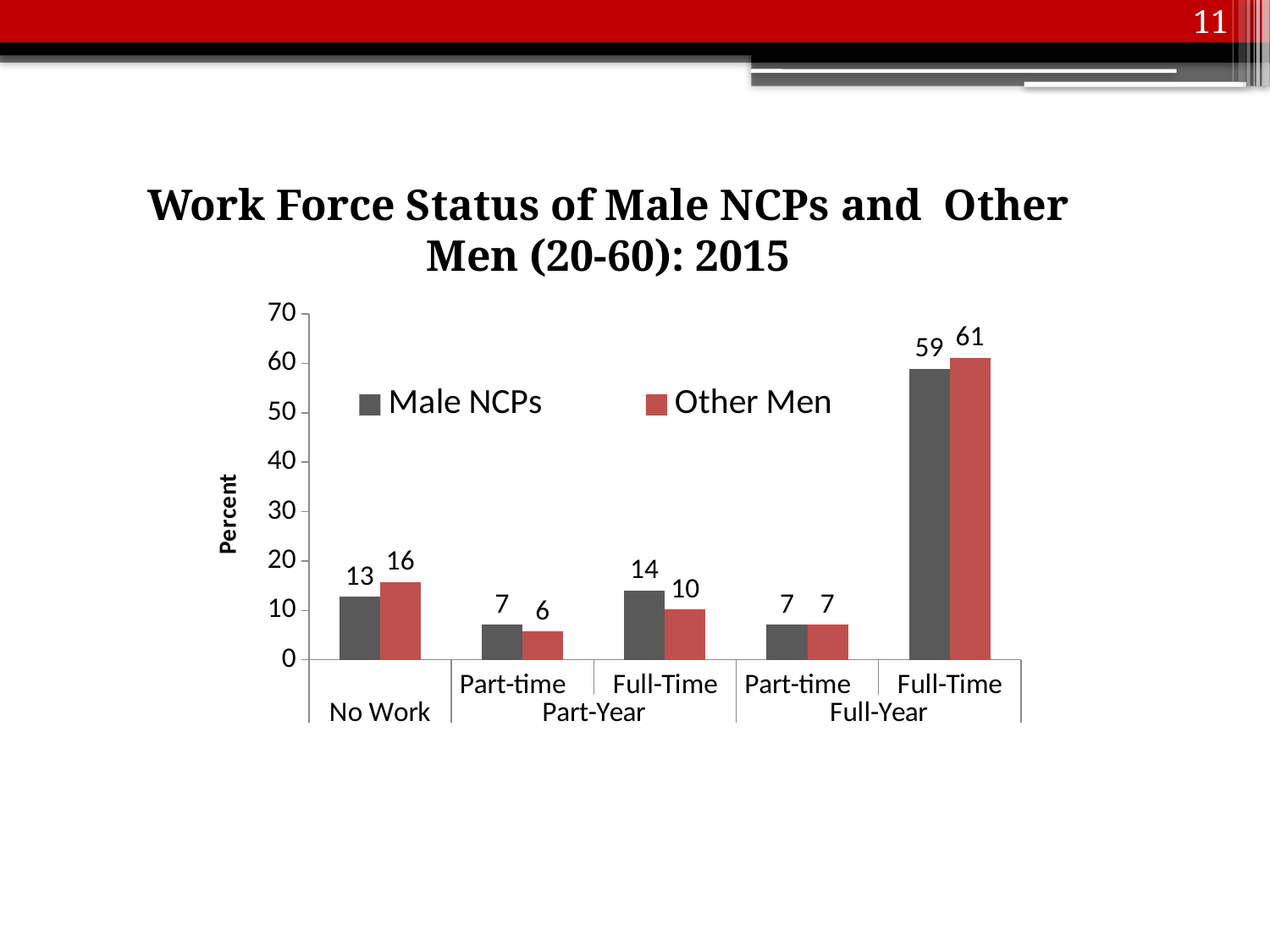
How many series does the legend list? 2 What is the value for Male NCPs in the No Work category? 13 How many categories are shown on the x axis? 5 What is the value for Other Men in the Full-Year Full-Time category? 61 What kind of chart is shown on the slide? Bar chart What is the label of the y axis? Percent What is the value for Other Men in the Part-Year Full-Time category? 10 What is the difference between Other Men and Male NCPs in the No Work category? 3 Which category has the lowest value for Other Men? Part-Year Part-time Which category has the highest value for Male NCPs? Full-Year Full-Time Is the value for Male NCPs in the Full-Year Full-Time category greater or less than 50? greater In the Part-Year Full-Time category, which series has the larger value, Male NCPs or Other Men? Male NCPs